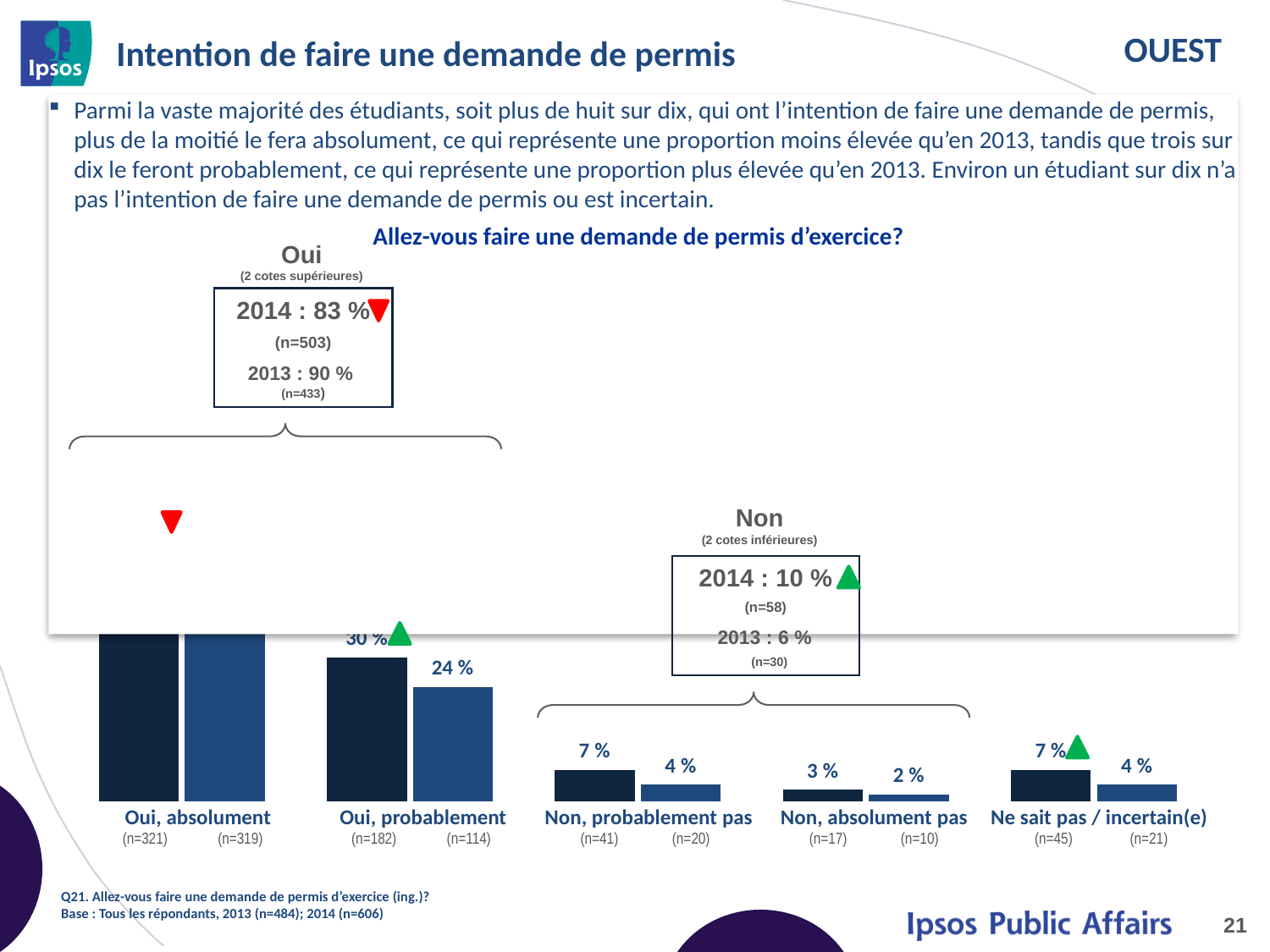
Which category has the lowest 2013 value (right bar) among the labelled bars? Non, absolument pas What is the 2014 value (left bar) for 'Oui, probablement'? 30 % Which is larger: the 2014 value for 'Non, probablement pas' or the 2014 value for 'Non, absolument pas'? Non, probablement pas What is the 2013 value (right bar) for 'Oui, probablement'? 24 % What is the title of the chart? Allez-vous faire une demande de permis d'exercice? How many response categories are shown along the x axis of the chart? 5 What is the 2014 value (left bar) for 'Ne sait pas / incertain(e)'? 7 % What is the difference between the 2014 and 2013 values for 'Oui, probablement'? 6 % What is the 2014 value (left bar) for 'Non, probablement pas'? 7 % What is the 2013 value (right bar) for 'Non, absolument pas'? 2 % What kind of chart is shown on the slide? bar chart According to the summary box, what was the 'Oui (2 cotes supérieures)' percentage in 2014? 83 %